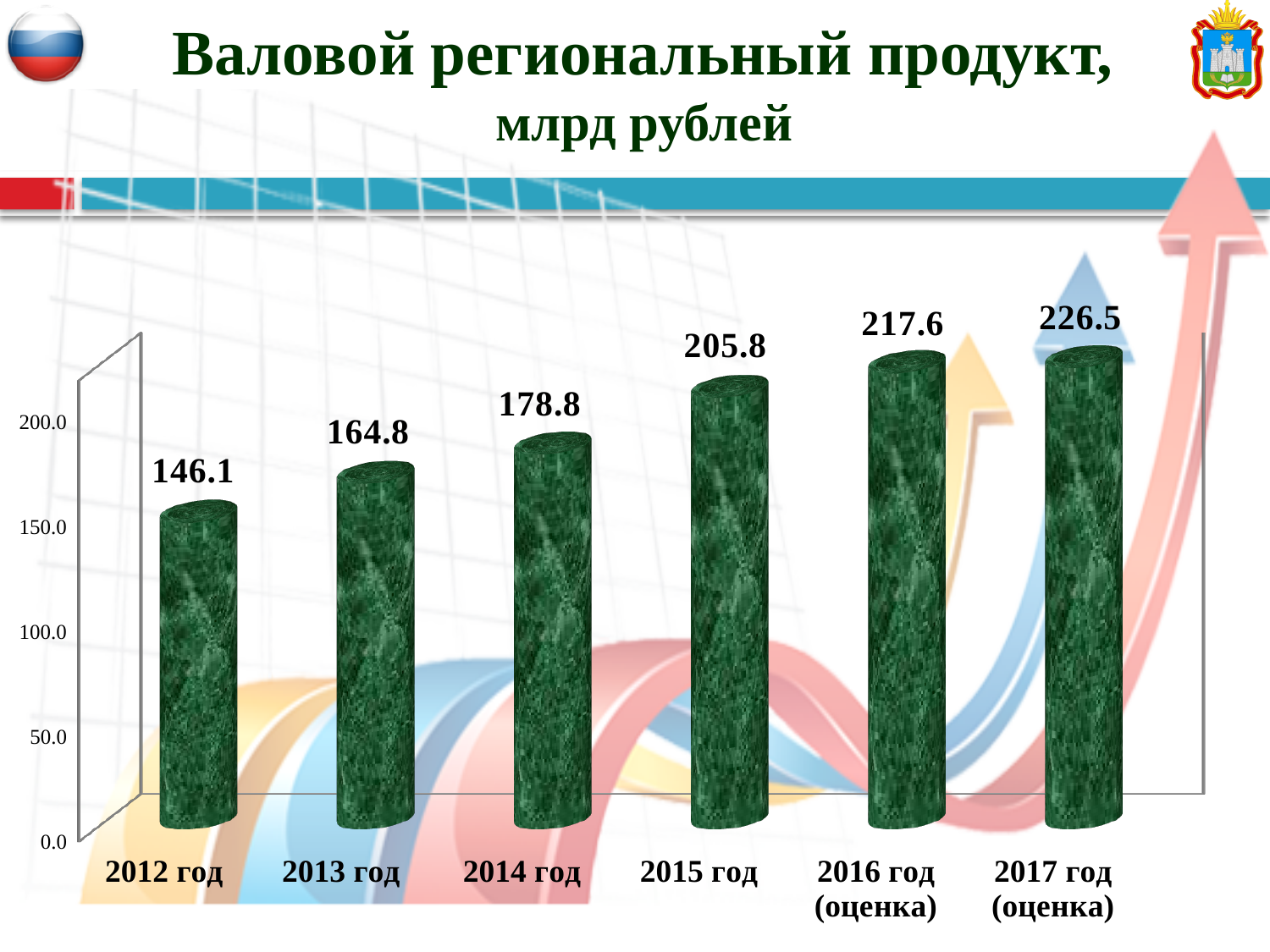
Which is larger, the value for 2016 год (оценка) or the value for 2015 год? 2016 год (оценка) What is the difference between the values for 2014 год and 2013 год? 14.0 What is the value for 2015 год? 205.8 How many years are shown on the chart? 6 Which year has the lowest value? 2012 год Is the value for 2013 год greater or less than 150.0? greater Which year has the highest value? 2017 год (оценка) Do the values rise or fall from 2012 год to 2017 год (оценка)? rise What is the value for 2012 год? 146.1 What is the difference between the values for 2017 год (оценка) and 2012 год? 80.4 What kind of chart is shown on the slide? bar chart What is the value for 2017 год (оценка)? 226.5